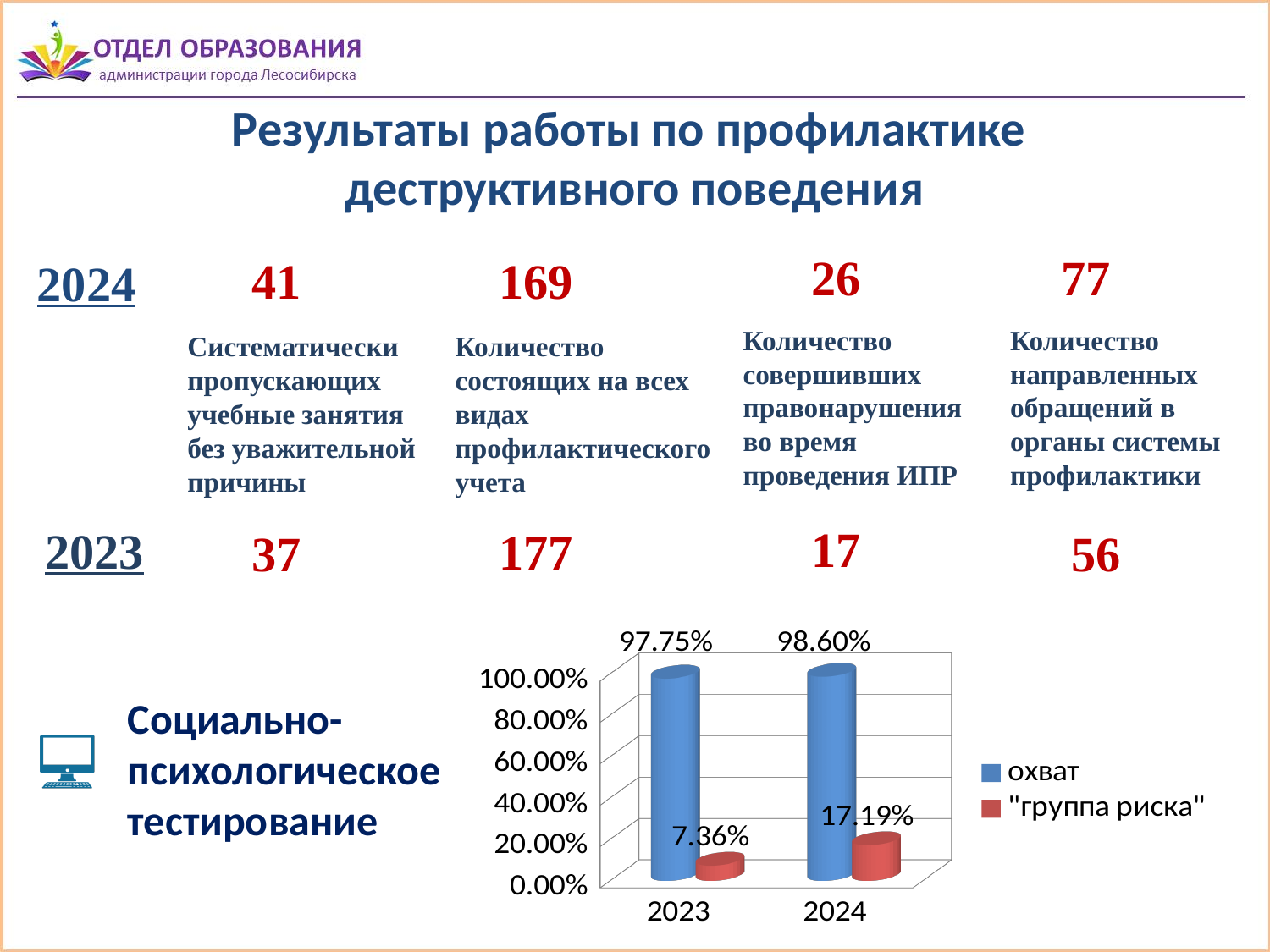
In which year is the "группа риска" value higher? 2024 What is the difference between the "группа риска" values for 2024 and 2023? 9.83% Is the "охват" value for 2024 greater or less than 80.00%? greater Does the "группа риска" value rise or fall from 2023 to 2024? rise What is the value of "группа риска" for 2024? 17.19% Which colour represents the "охват" series in the chart? blue How many series does the chart legend list? 2 What is the value of "группа риска" for 2023? 7.36% What is the value of "охват" for 2024? 98.60% What kind of chart is shown on the slide? bar chart How many categories are shown on the x axis of the chart? 2 What is the value of "охват" for 2023? 97.75%